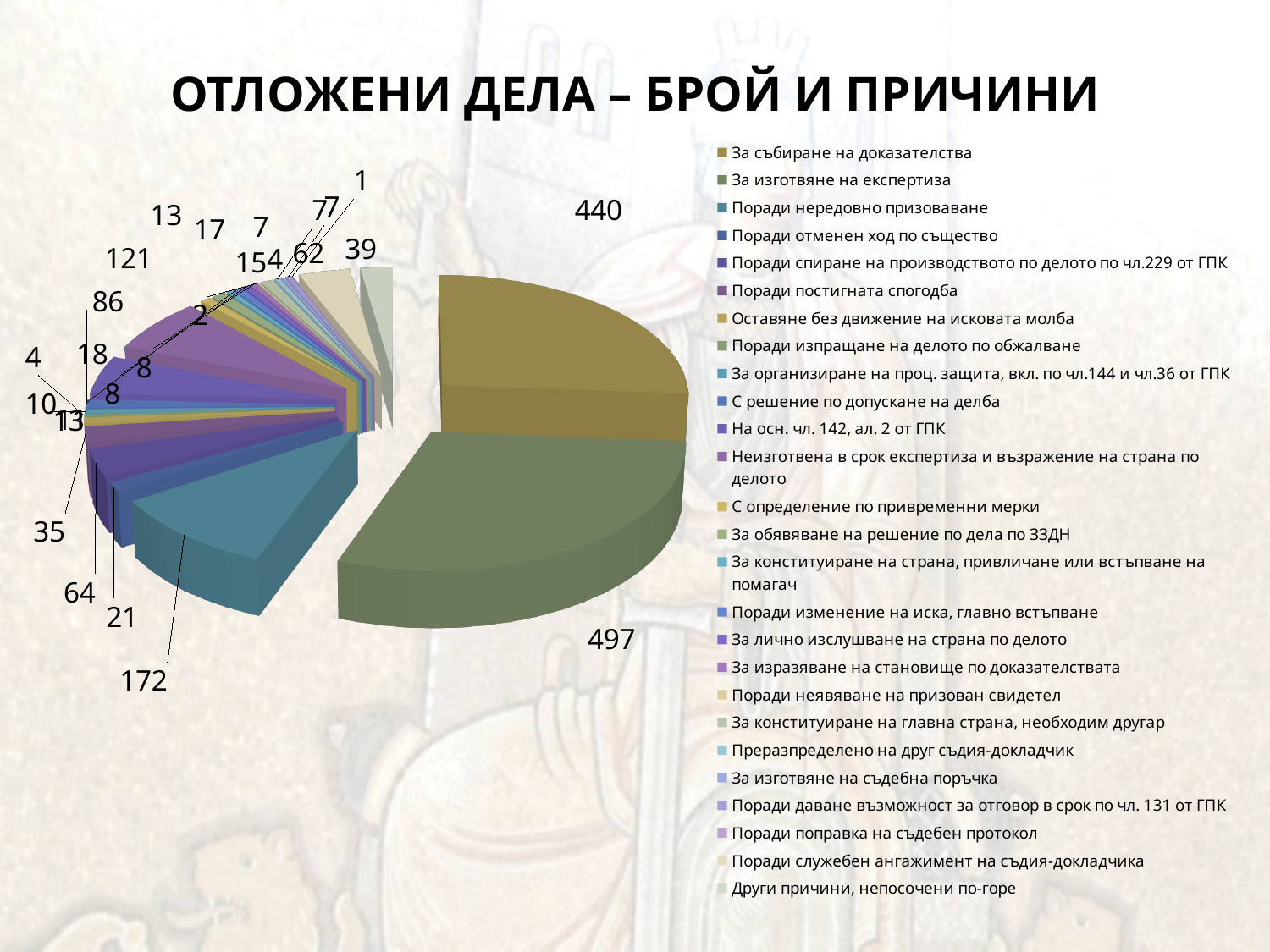
How many entries does the legend list? 26 What kind of chart is shown on the slide? pie chart Which is larger, the value for "Поради нередовно призоваване" or for "За събиране на доказателства"? За събиране на доказателства What is the value for "За събиране на доказателства"? 440 Which category has the largest slice of the pie? За изготвяне на експертиза What is the value for "За изготвяне на експертиза"? 497 What is the difference between the values for "За изготвяне на експертиза" and "За събиране на доказателства"? 57 What is the difference between the values for "За събиране на доказателства" and "Поради нередовно призоваване"? 268 What is the value for "Поради нередовно призоваване"? 172 Which is larger, the value for "За изготвяне на експертиза" or for "За събиране на доказателства"? За изготвяне на експертиза What is the title of the chart? ОТЛОЖЕНИ ДЕЛА – БРОЙ И ПРИЧИНИ